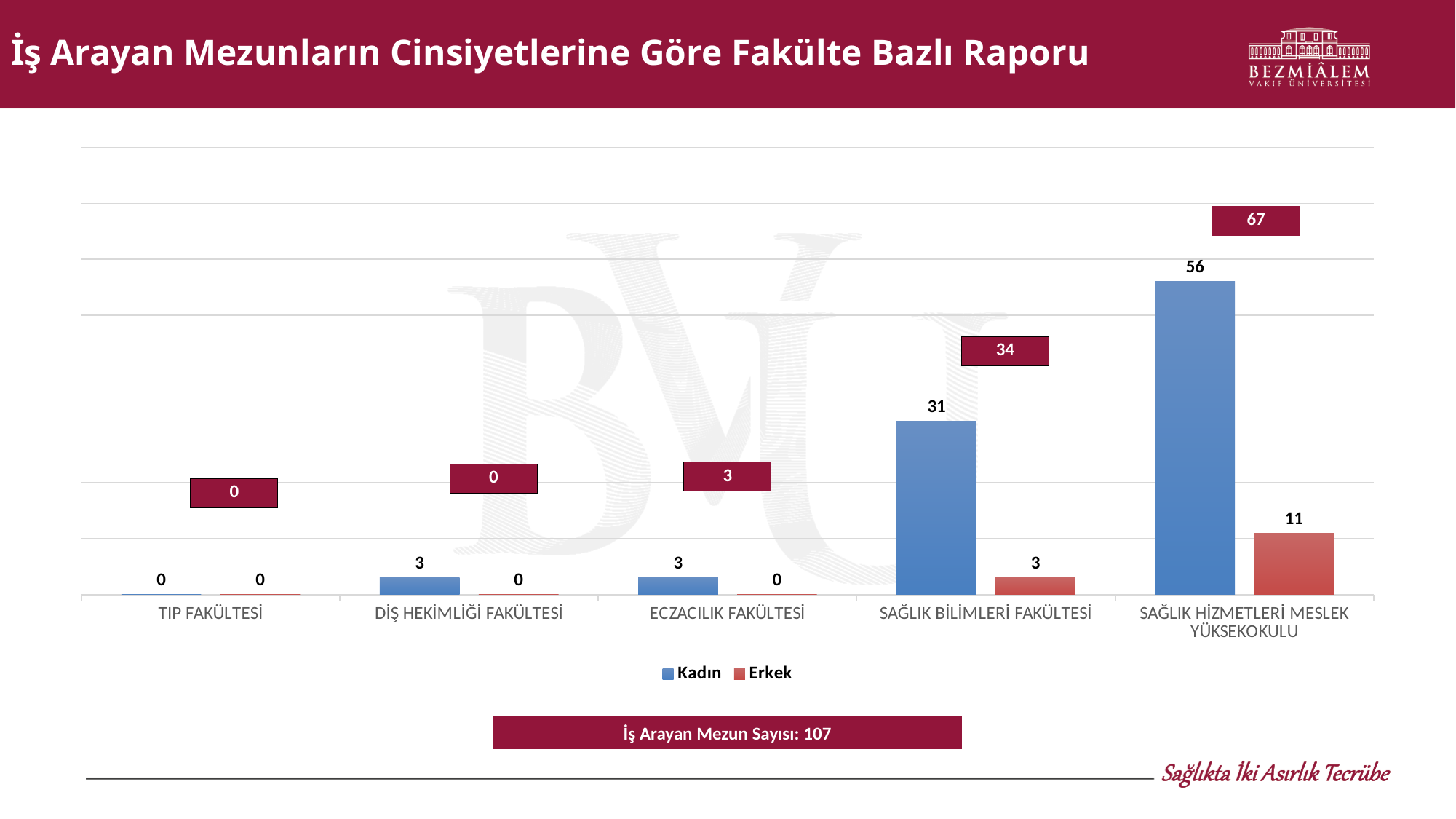
What type of chart is shown on the slide? bar chart Which faculty has the highest Erkek value? SAĞLIK HİZMETLERİ MESLEK YÜKSEKOKULU What is the difference between the Kadın and Erkek values for SAĞLIK HİZMETLERİ MESLEK YÜKSEKOKULU? 45 How many faculty categories are shown on the x axis? 5 What total number of job-seeking graduates (İş Arayan Mezun Sayısı) is stated below the chart? 107 What is the Erkek value for SAĞLIK BİLİMLERİ FAKÜLTESİ? 3 What is the combined total of Kadın and Erkek for SAĞLIK BİLİMLERİ FAKÜLTESİ? 34 Which faculty has the highest Kadın value? SAĞLIK HİZMETLERİ MESLEK YÜKSEKOKULU What is the Kadın value for SAĞLIK HİZMETLERİ MESLEK YÜKSEKOKULU? 56 How many series does the legend list? 2 Which is larger for SAĞLIK BİLİMLERİ FAKÜLTESİ, the Kadın value or the Erkek value? Kadın What is the Kadın value for ECZACILIK FAKÜLTESİ? 3